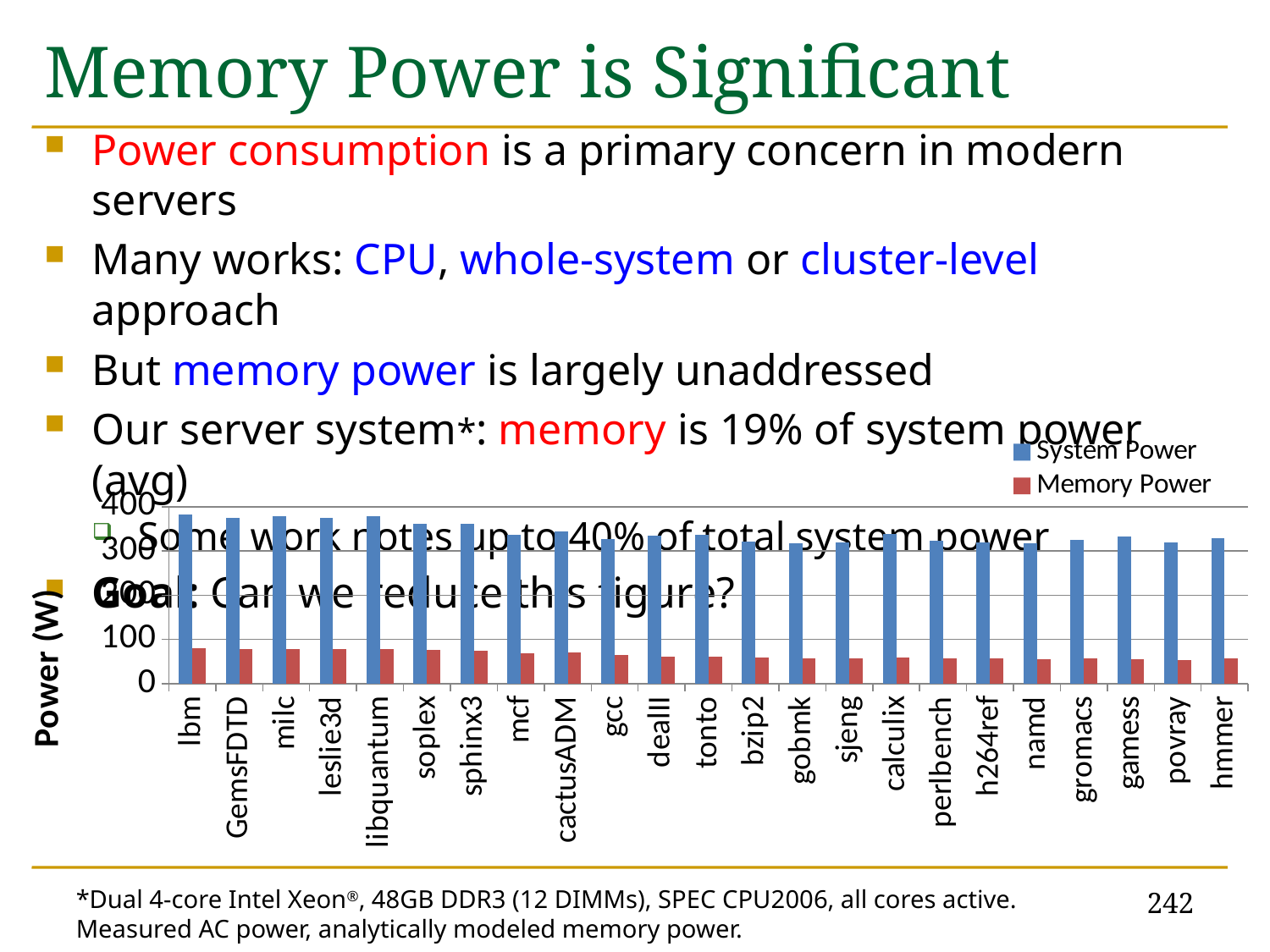
Is the System Power value for lbm greater or less than 300? greater What are the two series named in the chart's legend? System Power and Memory Power Is the System Power value for gobmk greater or less than 400? less What is the label on the chart's vertical axis? Power (W) What kind of chart is shown on the slide? bar chart How many series does the chart's legend list? 2 Which has the larger System Power value, lbm or povray? lbm Do the Memory Power values generally rise or fall moving from left to right along the x axis? fall Is the System Power value for hmmer greater or less than 200? greater Which has the larger Memory Power value, lbm or hmmer? lbm How many benchmark categories are plotted along the x axis of the chart? 23